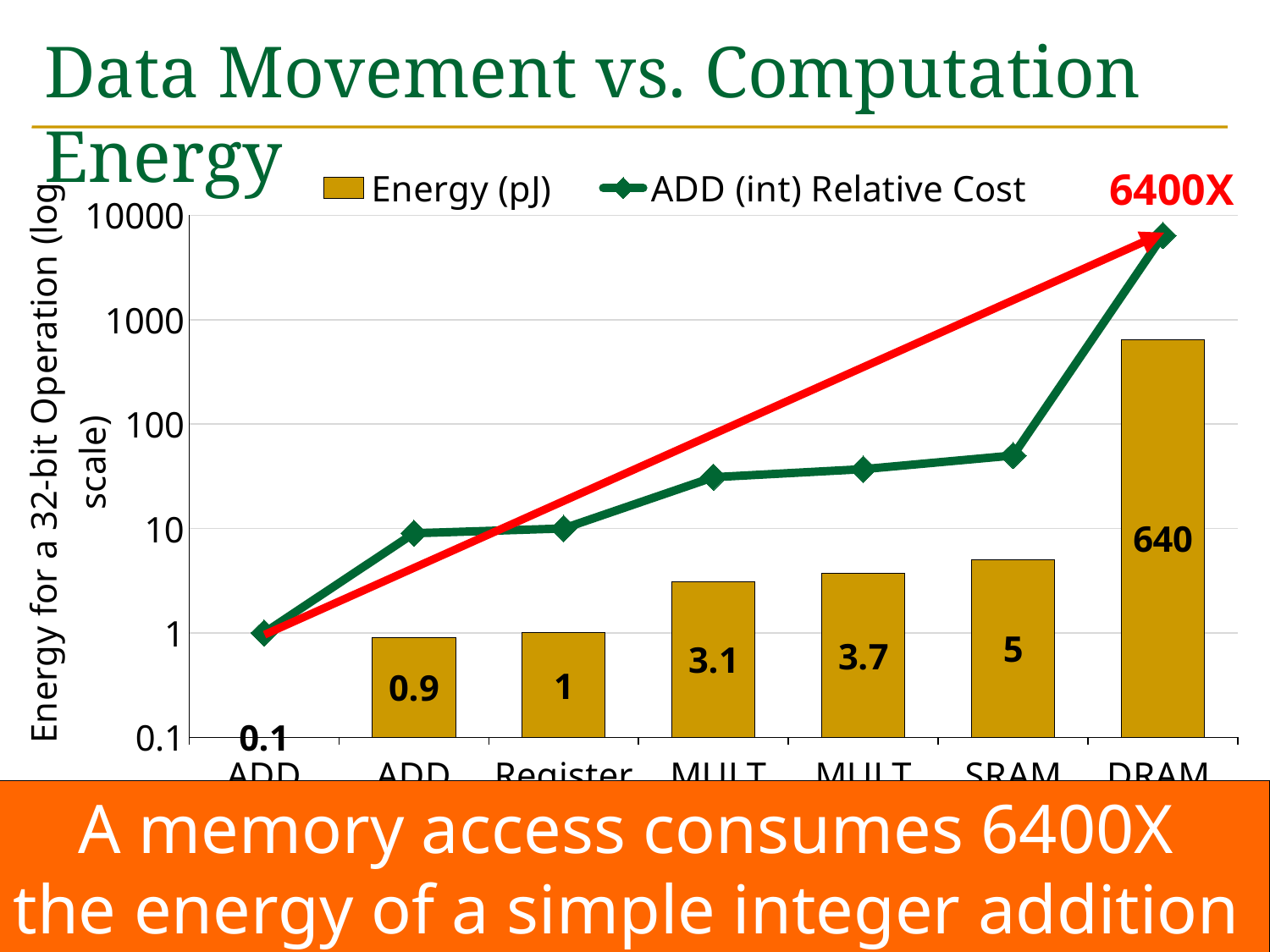
What kind of chart is this? Combined bar and line chart Which has a larger Energy (pJ) value, SRAM or Register? SRAM How many categories are shown on the x axis? 7 How many series does the legend list? 2 What is the Energy (pJ) value shown for DRAM? 640 Is the ADD (int) Relative Cost value at DRAM greater or less than 1000? greater Which category has the highest Energy (pJ) bar? DRAM Which category has the lowest Energy (pJ) value? ADD (the first category, 0.1) What is the Energy (pJ) value shown for Register? 1 What is the difference between the Energy (pJ) values for DRAM and SRAM? 635 What is the Energy (pJ) value shown for SRAM? 5 Is the ADD (int) Relative Cost value at SRAM greater or less than 10? greater